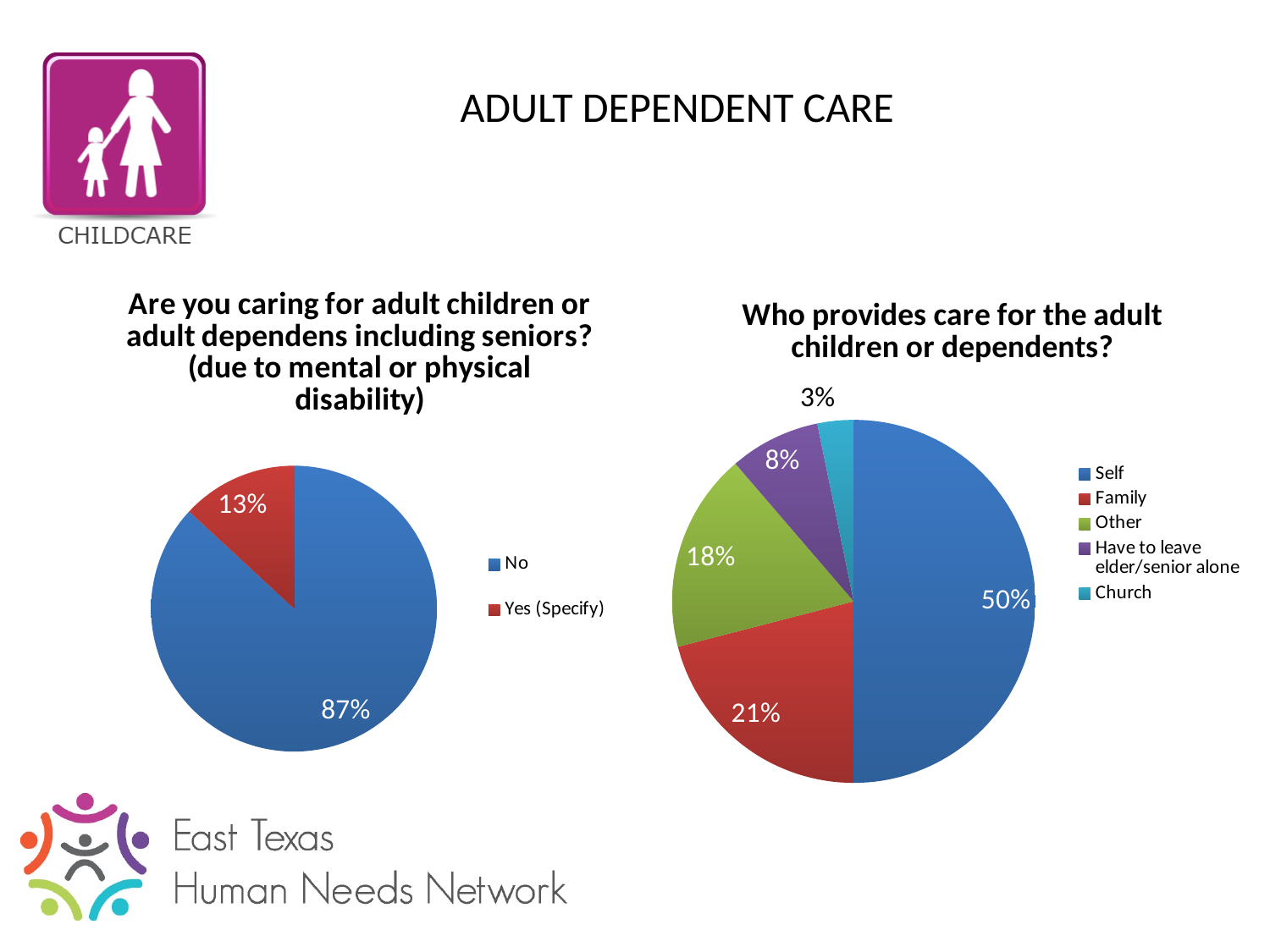
In the left pie chart ("Are you caring for adult children or adult dependens..."), what percentage answered "No"? 87% In the right pie chart ("Who provides care for the adult children or dependents?"), what percentage is "Family"? 21% In the right pie chart ("Who provides care for the adult children or dependents?"), which is larger, "Family" or "Other"? Family In the right pie chart ("Who provides care for the adult children or dependents?"), how many categories does the legend list? 5 What type of chart is used for "Who provides care for the adult children or dependents?"? Pie chart In the left pie chart ("Are you caring for adult children or adult dependens..."), what percentage answered "Yes (Specify)"? 13% In the left pie chart ("Are you caring for adult children or adult dependens..."), how many slices does the pie have? 2 In the right pie chart ("Who provides care for the adult children or dependents?"), which category has the largest share? Self In the left pie chart ("Are you caring for adult children or adult dependens..."), what is the difference between the "No" and "Yes (Specify)" shares? 74% In the right pie chart ("Who provides care for the adult children or dependents?"), which category has the smallest share? Church In the right pie chart ("Who provides care for the adult children or dependents?"), what percentage is "Self"? 50% In the right pie chart ("Who provides care for the adult children or dependents?"), what percentage is "Have to leave elder/senior alone"? 8%